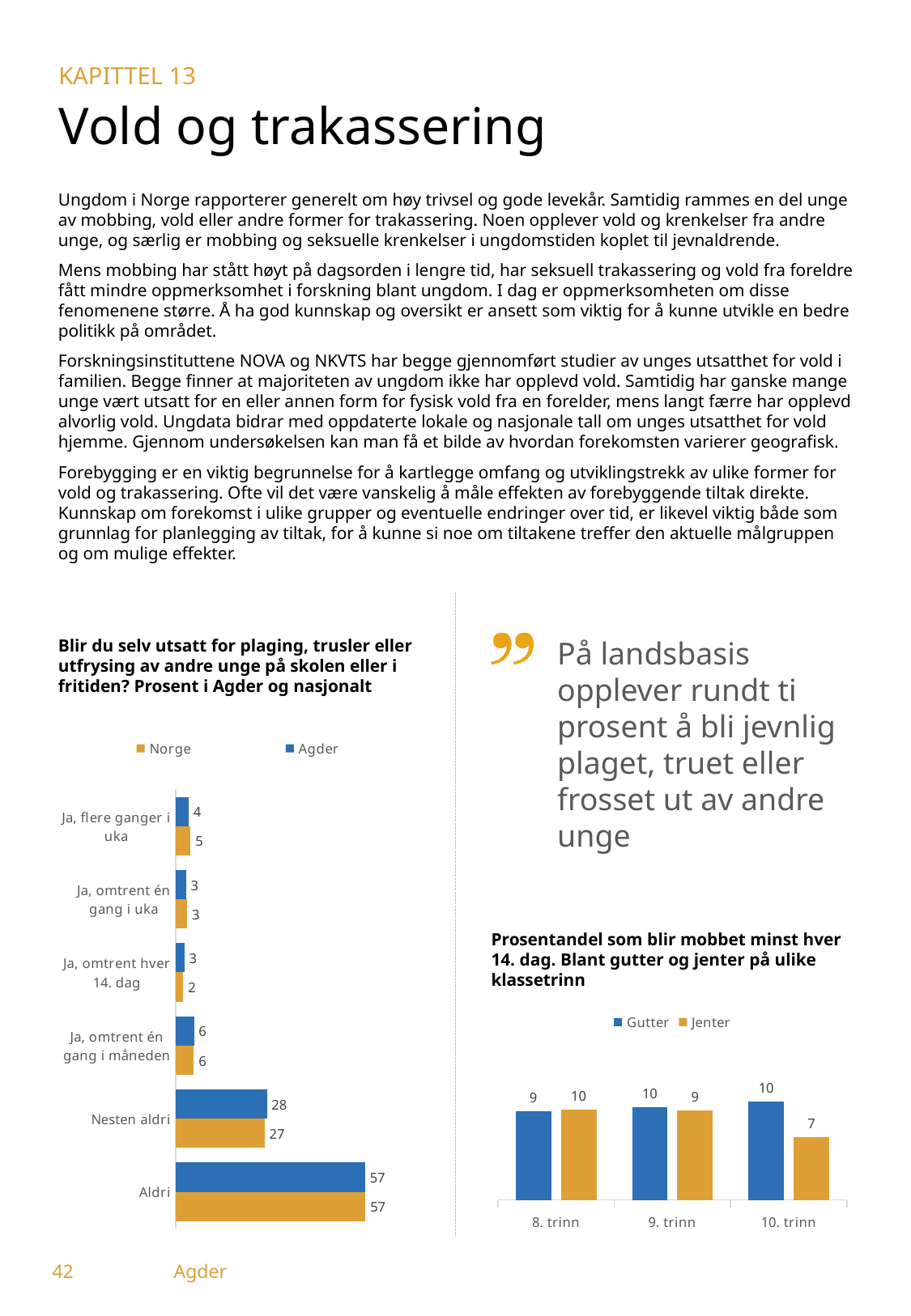
In the chart 'Blir du selv utsatt for plaging, trusler eller utfrysing av andre unge på skolen eller i fritiden?', how many series does the legend list? 2 In the chart 'Blir du selv utsatt for plaging, trusler eller utfrysing av andre unge på skolen eller i fritiden?', which category has the highest value for Agder? Aldri In the chart 'Prosentandel som blir mobbet minst hver 14. dag', what is the value for Gutter in 9. trinn? 10 In the chart 'Prosentandel som blir mobbet minst hver 14. dag', which colour represents Jenter? Orange In the chart 'Blir du selv utsatt for plaging, trusler eller utfrysing av andre unge på skolen eller i fritiden?', how many response categories are shown? 6 What kind of chart is 'Blir du selv utsatt for plaging, trusler eller utfrysing av andre unge på skolen eller i fritiden?'? Bar chart In the chart 'Prosentandel som blir mobbet minst hver 14. dag', what is the difference between Gutter and Jenter in 10. trinn? 3 In the chart 'Blir du selv utsatt for plaging, trusler eller utfrysing av andre unge på skolen eller i fritiden?', what is the Agder value for 'Nesten aldri'? 28 In the chart 'Blir du selv utsatt for plaging, trusler eller utfrysing av andre unge på skolen eller i fritiden?', what is the difference between the Agder and Norge values for 'Nesten aldri'? 1 In the chart 'Blir du selv utsatt for plaging, trusler eller utfrysing av andre unge på skolen eller i fritiden?', what is the Norge value for 'Ja, flere ganger i uka'? 5 In the chart 'Prosentandel som blir mobbet minst hver 14. dag', which is larger in 10. trinn, Gutter or Jenter? Gutter In the chart 'Prosentandel som blir mobbet minst hver 14. dag', what is the value for Jenter in 10. trinn? 7